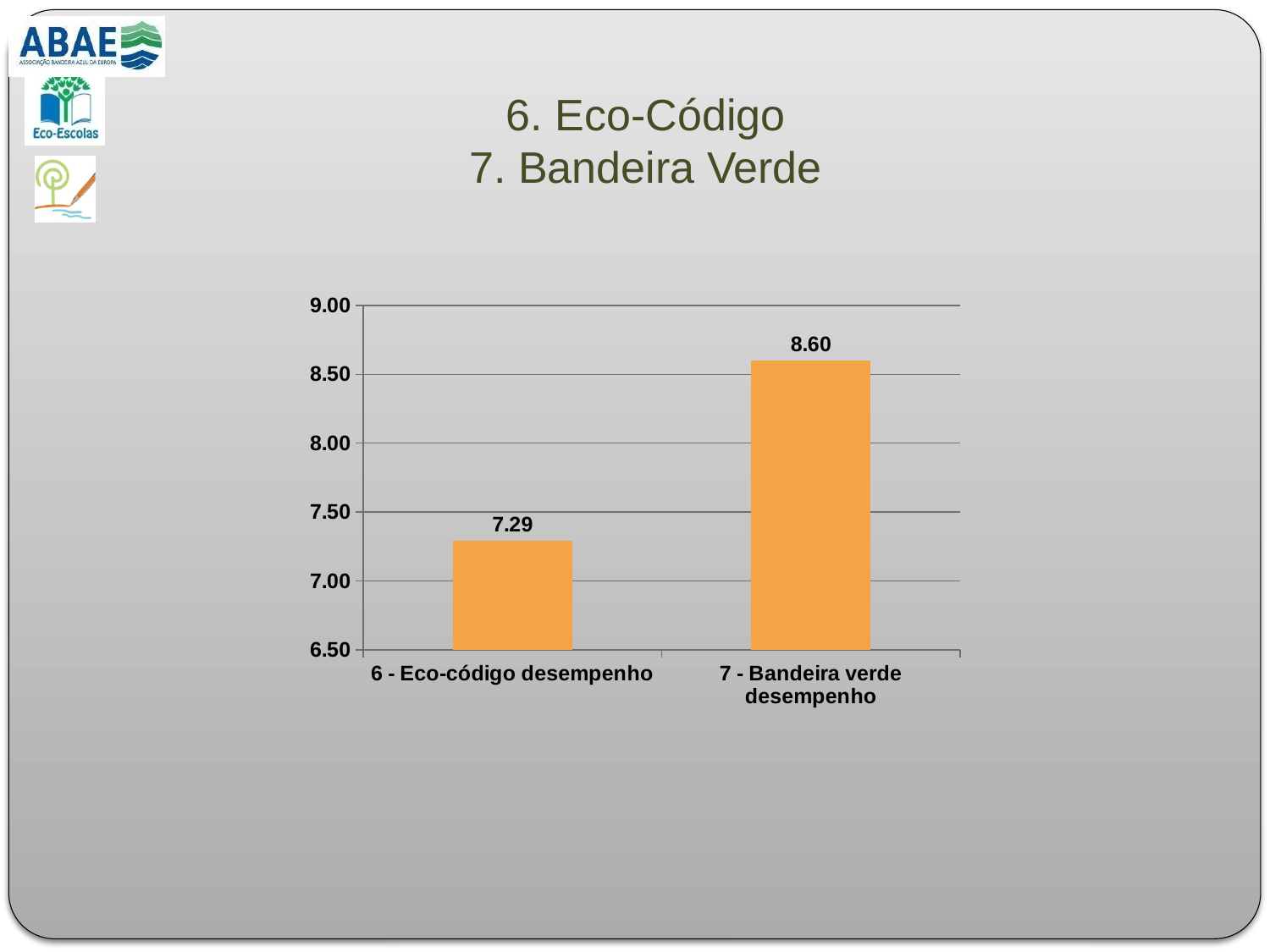
How many categories are shown in the chart? 2 Which is larger, the value for 6 - Eco-código desempenho or the value for 7 - Bandeira verde desempenho? 7 - Bandeira verde desempenho Is the value for 7 - Bandeira verde desempenho greater or less than 8.50? greater Do the values rise or fall from left to right along the x axis? rise What is the value for 7 - Bandeira verde desempenho? 8.60 What colour are the bars in the chart? orange Is the value for 6 - Eco-código desempenho greater or less than 7.50? less Which category has the highest value? 7 - Bandeira verde desempenho What kind of chart is shown on the slide? bar chart What is the value for 6 - Eco-código desempenho? 7.29 Which category has the lowest value? 6 - Eco-código desempenho What is the difference between the values for 7 - Bandeira verde desempenho and 6 - Eco-código desempenho? 1.31